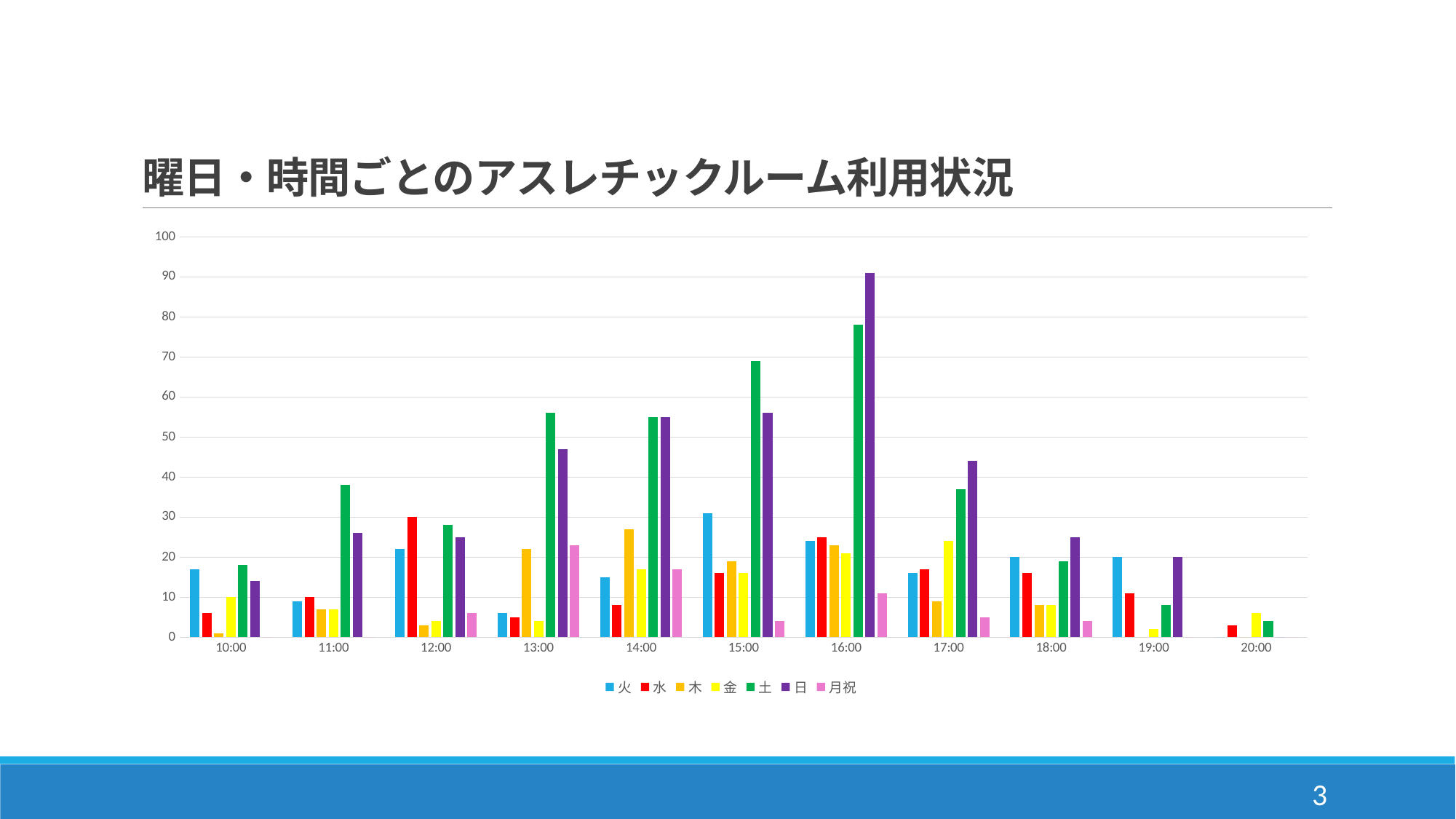
What is the title of the slide? 曜日・時間ごとのアスレチックルーム利用状況 At 12:00, which is larger, 水 or 火? 水 Is the value for 土 at 15:00 greater or less than 60? greater Do the 土 values rise or fall from 16:00 to 20:00? fall How many series does the legend list? 7 At which time is the 日 bar the highest? 16:00 What kind of chart is shown on the slide? bar chart At 13:00, which is larger, 土 or 日? 土 Is the value for 日 at 16:00 greater or less than 80? greater At 10:00, which series has the lowest bar? 月祝 How many time categories are shown on the x axis? 11 At 11:00, which series has the highest bar? 土